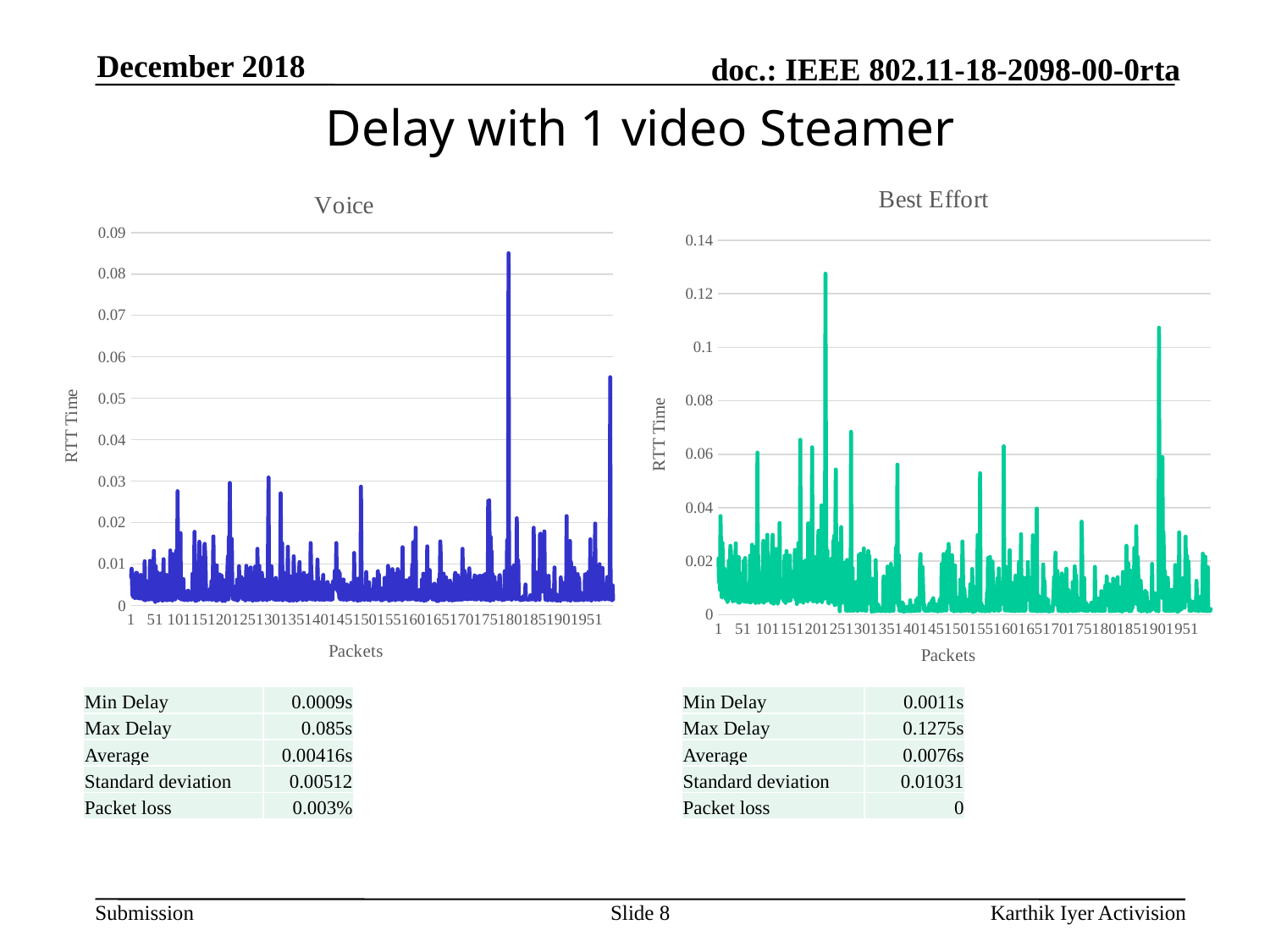
What kind of chart is the Best Effort chart? line chart What is the title of the chart on the left of the slide? Voice In the Best Effort chart, is the highest spike in RTT Time greater or less than 0.12? greater What is the label on the vertical axis of the Best Effort chart? RTT Time In the Voice chart, is the highest spike in RTT Time greater or less than 0.08? greater What kind of chart is the Voice chart? line chart Which chart shows the higher peak RTT Time, the Voice chart or the Best Effort chart? Best Effort